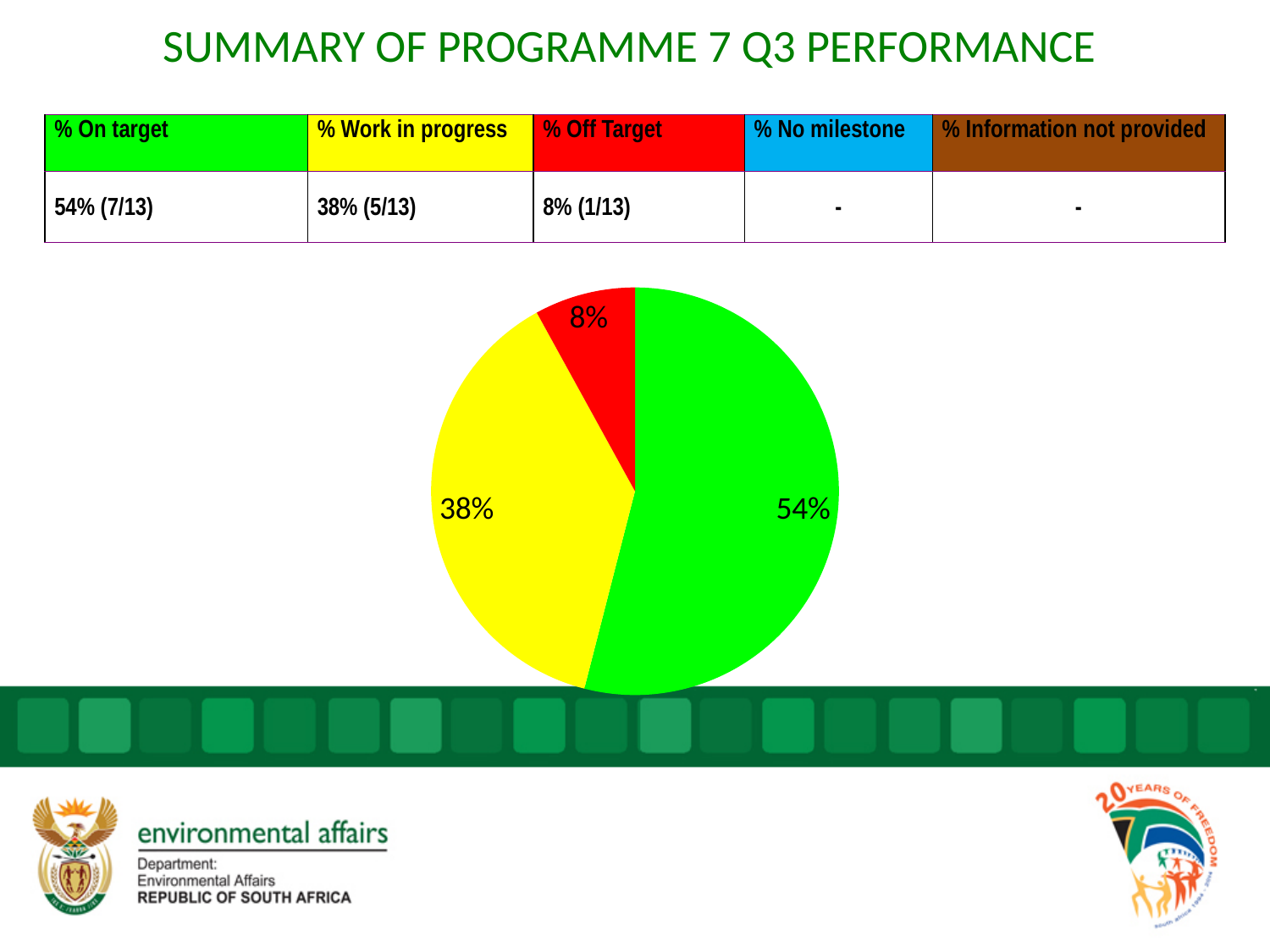
What kind of chart is shown on the slide? pie chart What is the difference between the yellow slice and the red slice of the pie chart? 30% According to the table above the pie chart, which category does the green slice represent? % On target What percentage is shown on the red slice of the pie chart? 8% What percentage is shown on the yellow slice of the pie chart? 38% Which slice of the pie chart is the smallest? 8% (red, Off Target) How many slices does the pie chart have? 3 Which is larger in the pie chart, the yellow slice or the red slice? yellow slice What percentage is shown on the green slice of the pie chart? 54% What is the difference between the green slice and the yellow slice of the pie chart? 16% According to the table above the pie chart, which category does the red slice represent? % Off Target Which slice of the pie chart is the largest? 54% (green, On target)